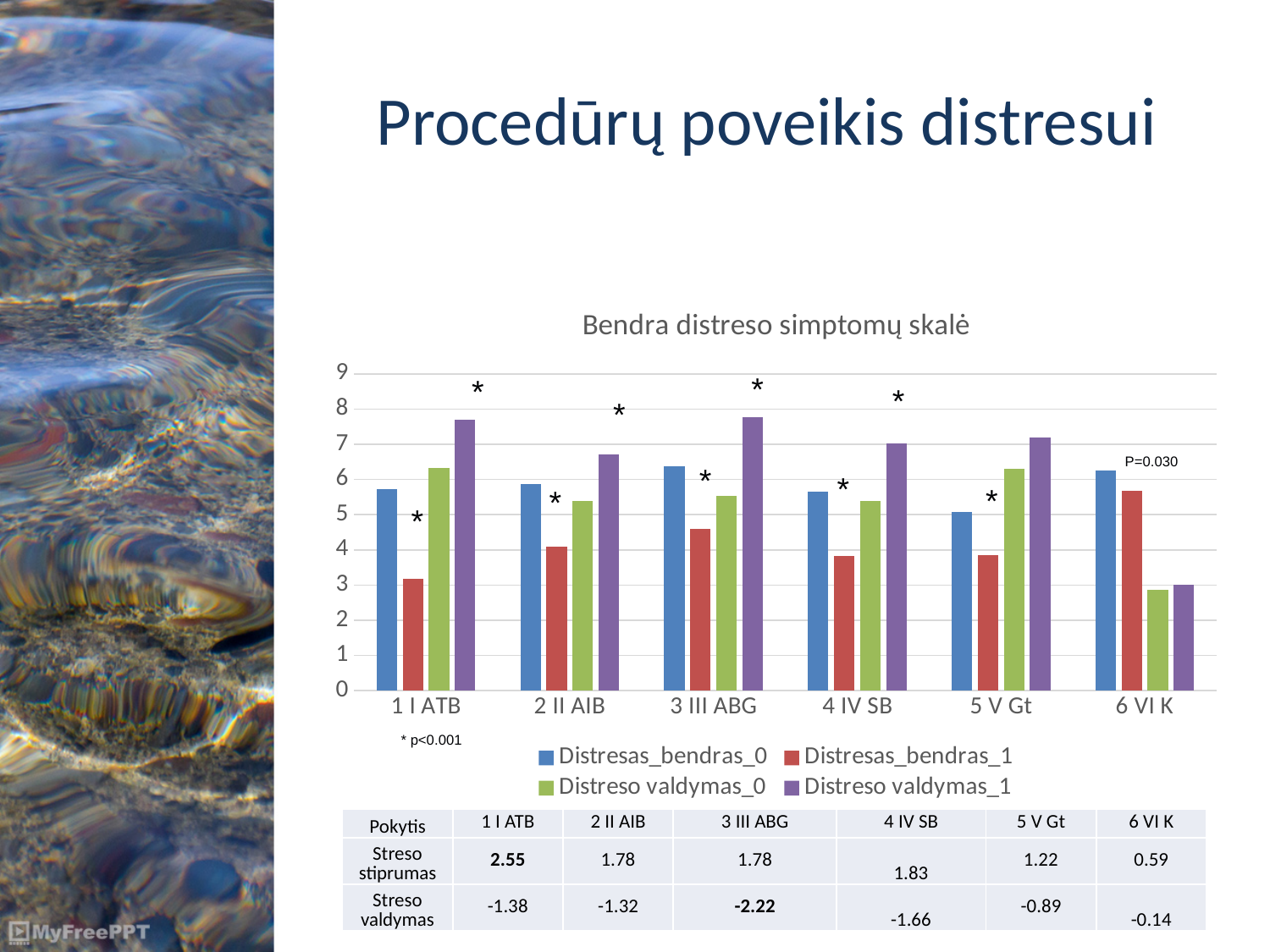
Which category has the lowest value for Distresas_bendras_1? 1 I ATB Is the value of Distreso valdymas_0 for 6 VI K greater or less than 4? less How many series does the chart legend list? 4 What is the title of the chart? Bendra distreso simptomų skalė Which category has the highest value for Distresas_bendras_1? 6 VI K For 6 VI K, which is larger: Distresas_bendras_0 or Distreso valdymas_0? Distresas_bendras_0 Which category has the lowest value for Distreso valdymas_1? 6 VI K What kind of chart is shown on the slide? bar chart Is the value of Distreso valdymas_1 for 3 III ABG greater or less than 7? greater Is the value of Distresas_bendras_1 for 1 I ATB greater or less than 4? less How many categories are shown on the x axis of the chart? 6 For 1 I ATB, which is larger: Distreso valdymas_1 or Distresas_bendras_0? Distreso valdymas_1